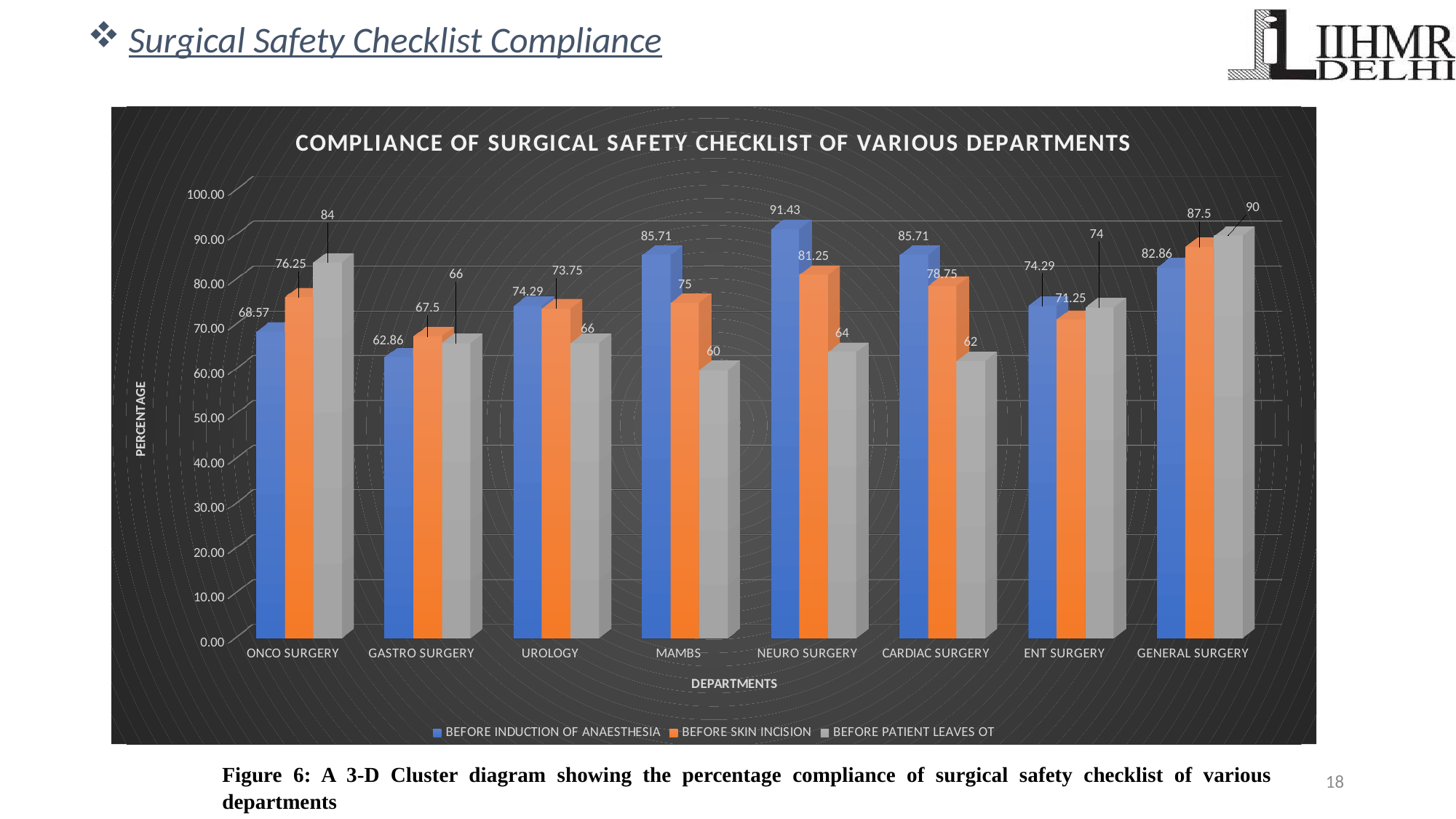
Which department has the lowest BEFORE SKIN INCISION value? GASTRO SURGERY What kind of chart is shown on the slide? Bar chart What is the BEFORE PATIENT LEAVES OT value for ONCO SURGERY? 84 What is the BEFORE SKIN INCISION value for GENERAL SURGERY? 87.5 How many series does the legend list? 3 What is the difference between the BEFORE INDUCTION OF ANAESTHESIA and BEFORE PATIENT LEAVES OT values for NEURO SURGERY? 27.43 How many departments are shown on the x axis? 8 Which department has the lowest BEFORE PATIENT LEAVES OT value? MAMBS Which is larger for CARDIAC SURGERY: the BEFORE SKIN INCISION value or the BEFORE PATIENT LEAVES OT value? BEFORE SKIN INCISION What is the BEFORE INDUCTION OF ANAESTHESIA compliance value for NEURO SURGERY? 91.43 Is the BEFORE INDUCTION OF ANAESTHESIA value for GASTRO SURGERY greater or less than 70.00? less Which department has the highest BEFORE INDUCTION OF ANAESTHESIA value? NEURO SURGERY